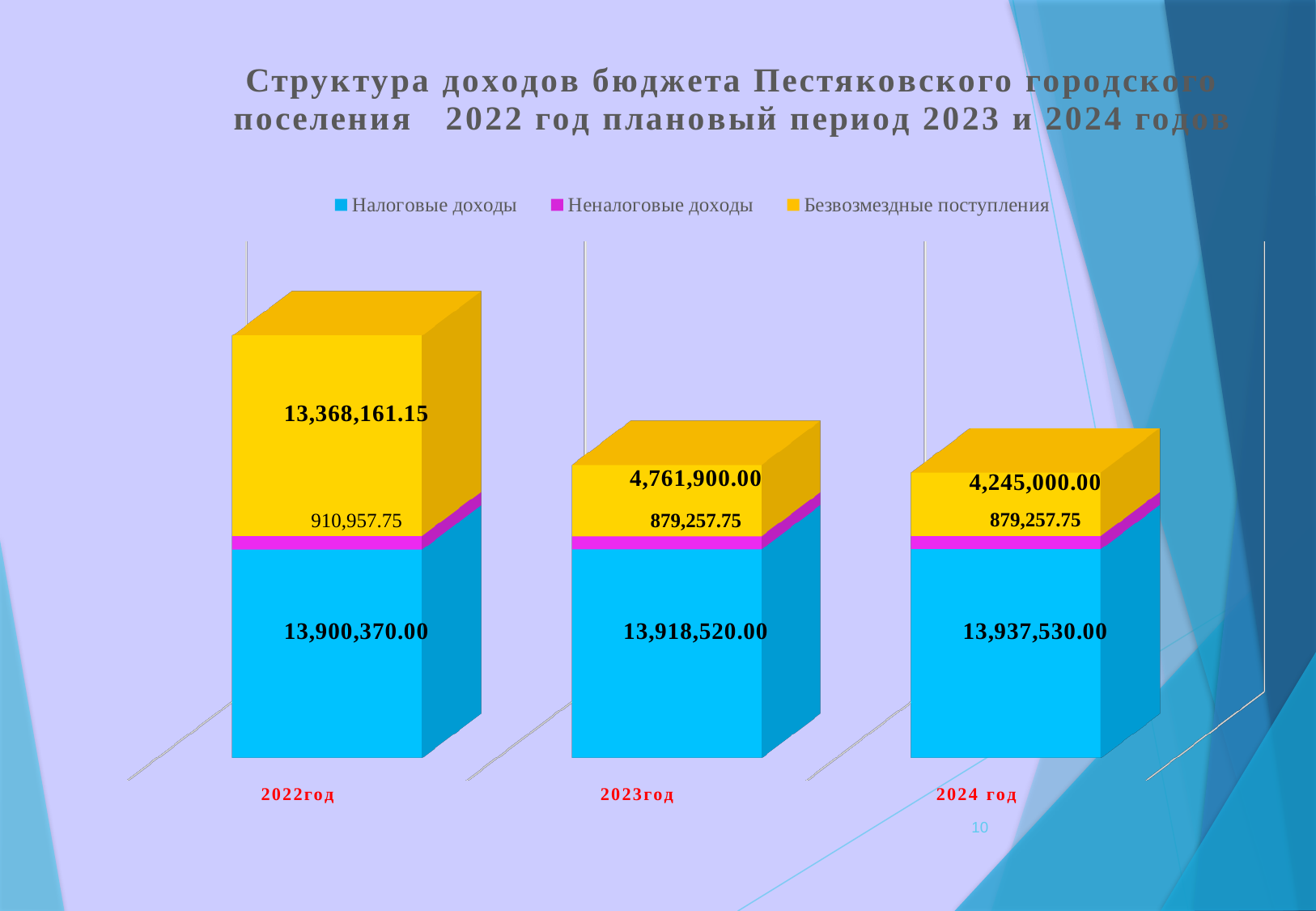
What is the value of Неналоговые доходы for 2024 год? 879,257.75 What is the value of Налоговые доходы for 2022год? 13,900,370.00 In which year is Налоговые доходы the lowest? 2022год How many series does the legend list? 3 Which is larger: Безвозмездные поступления in 2023год or in 2024 год? 2023год Do the Налоговые доходы values rise or fall from 2022год to 2024 год? Rise In which year is Безвозмездные поступления the highest? 2022год What is the value of Безвозмездные поступления for 2023год? 4,761,900.00 How many categories (years) are shown on the x axis? 3 What kind of chart is shown on the slide? Stacked bar chart What is the total of the stacked bar for 2023год? 19,559,677.75 What is the difference between Безвозмездные поступления in 2022год and 2023год? 8,606,261.15